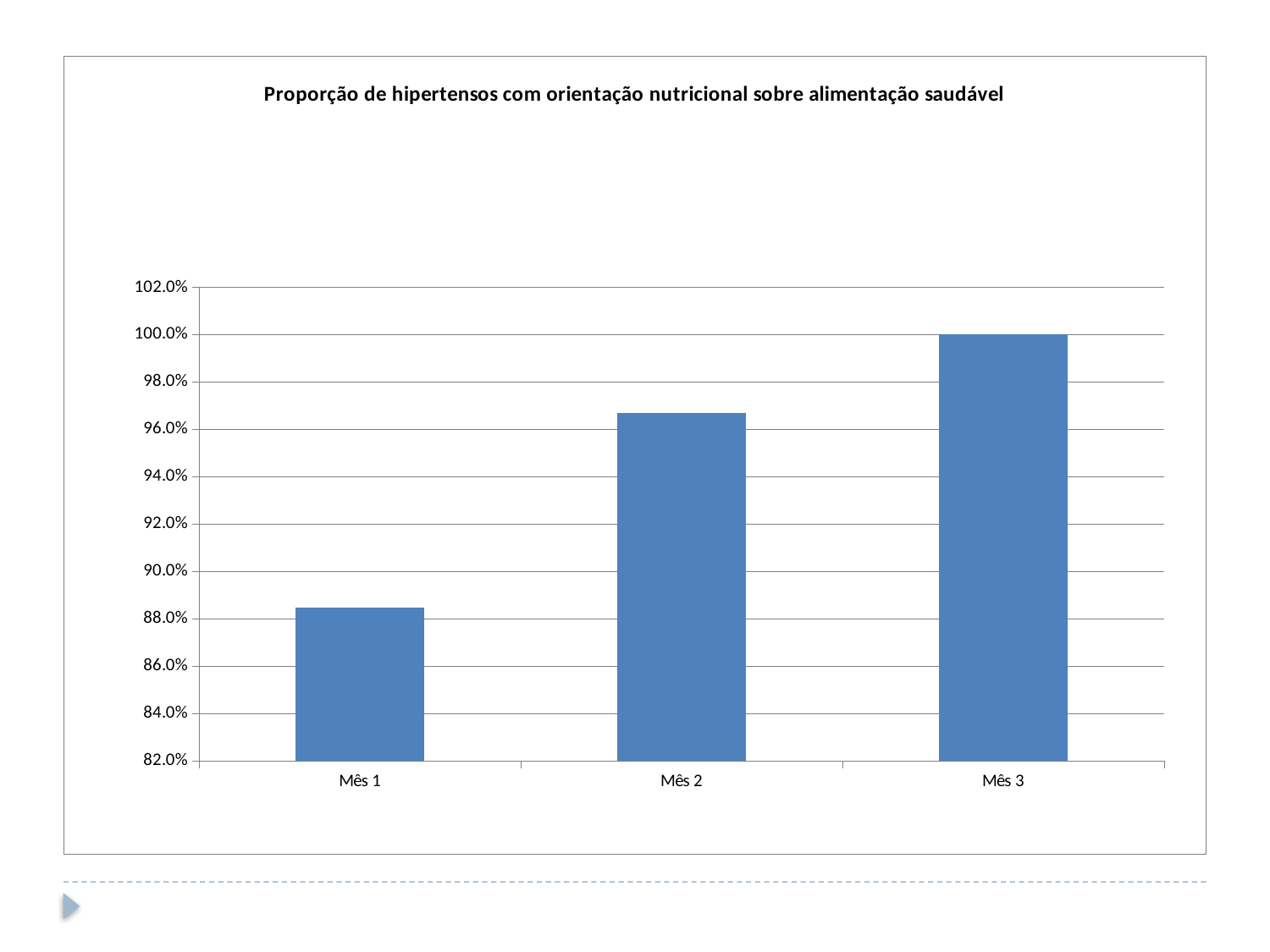
Is the value for Mês 2 greater or less than 98.0%? less Which month has the lowest value in the chart? Mês 1 Which month has the highest value in the chart? Mês 3 What is the title of the chart? Proporção de hipertensos com orientação nutricional sobre alimentação saudável Which is larger, the value for Mês 1 or the value for Mês 2? Mês 2 Do the values rise or fall from Mês 1 to Mês 3? rise Is the value for Mês 1 greater or less than 90.0%? less How many categories are shown on the x axis of the chart? 3 What is the value for Mês 3? 100.0% Is the value for Mês 1 greater or less than 88.0%? greater What kind of chart is shown on the slide? bar chart